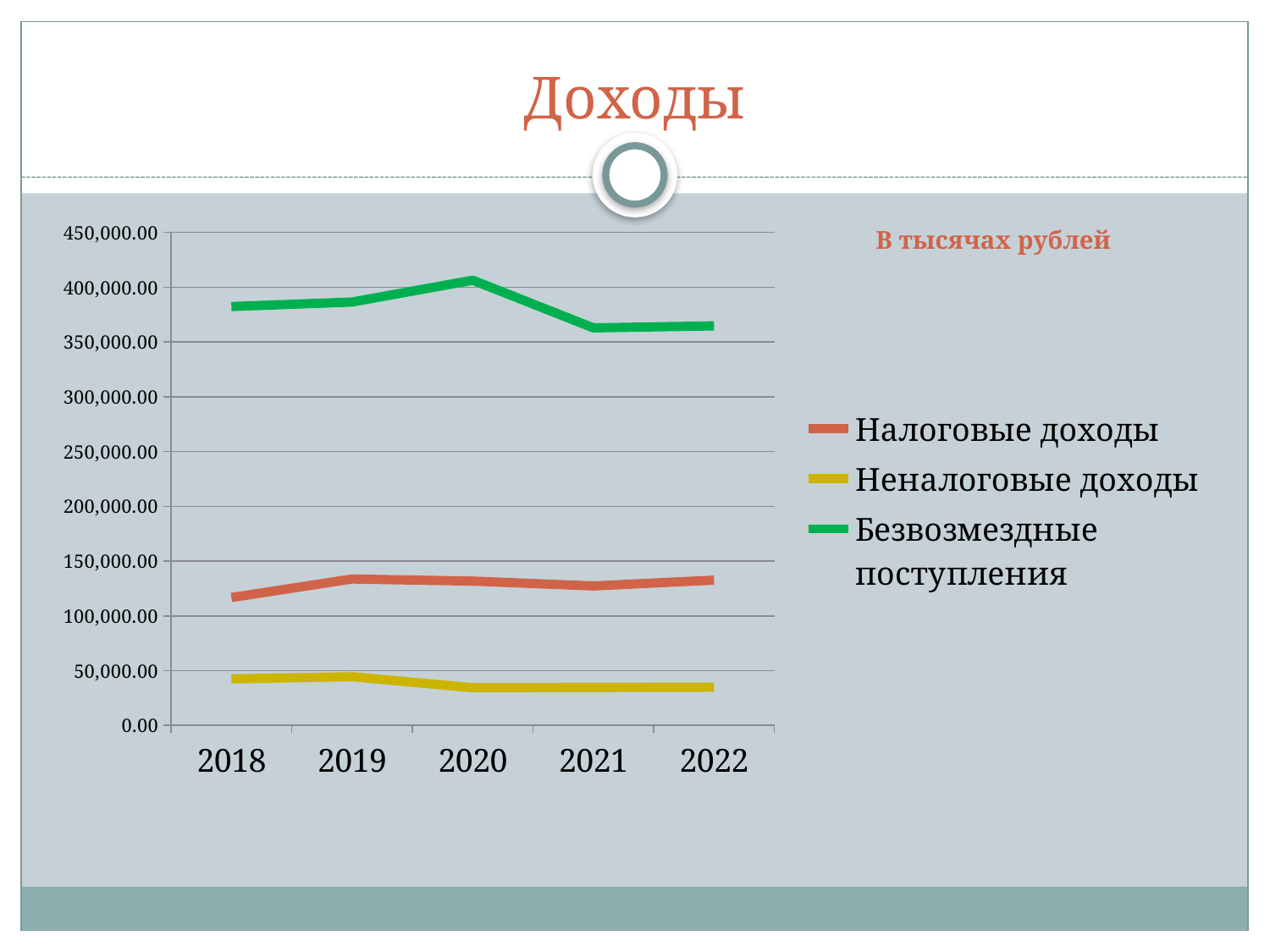
Is the value for Неналоговые доходы in 2020 greater or less than 50,000.00? less Is the value for Налоговые доходы in 2018 greater or less than 100,000.00? greater In what units are the values given, according to the note on the slide? В тысячах рублей How many years are shown on the x axis? 5 In which year is the value for Налоговые доходы lowest? 2018 Does the value for Безвозмездные поступления rise or fall from 2020 to 2021? fall What kind of chart is shown on the slide? line chart How many series does the legend list? 3 In which year is the value for Безвозмездные поступления highest? 2020 Is the value for Безвозмездные поступления in 2021 greater or less than 400,000.00? less Which is larger in 2022: Безвозмездные поступления or Налоговые доходы? Безвозмездные поступления What is the title of the slide? Доходы